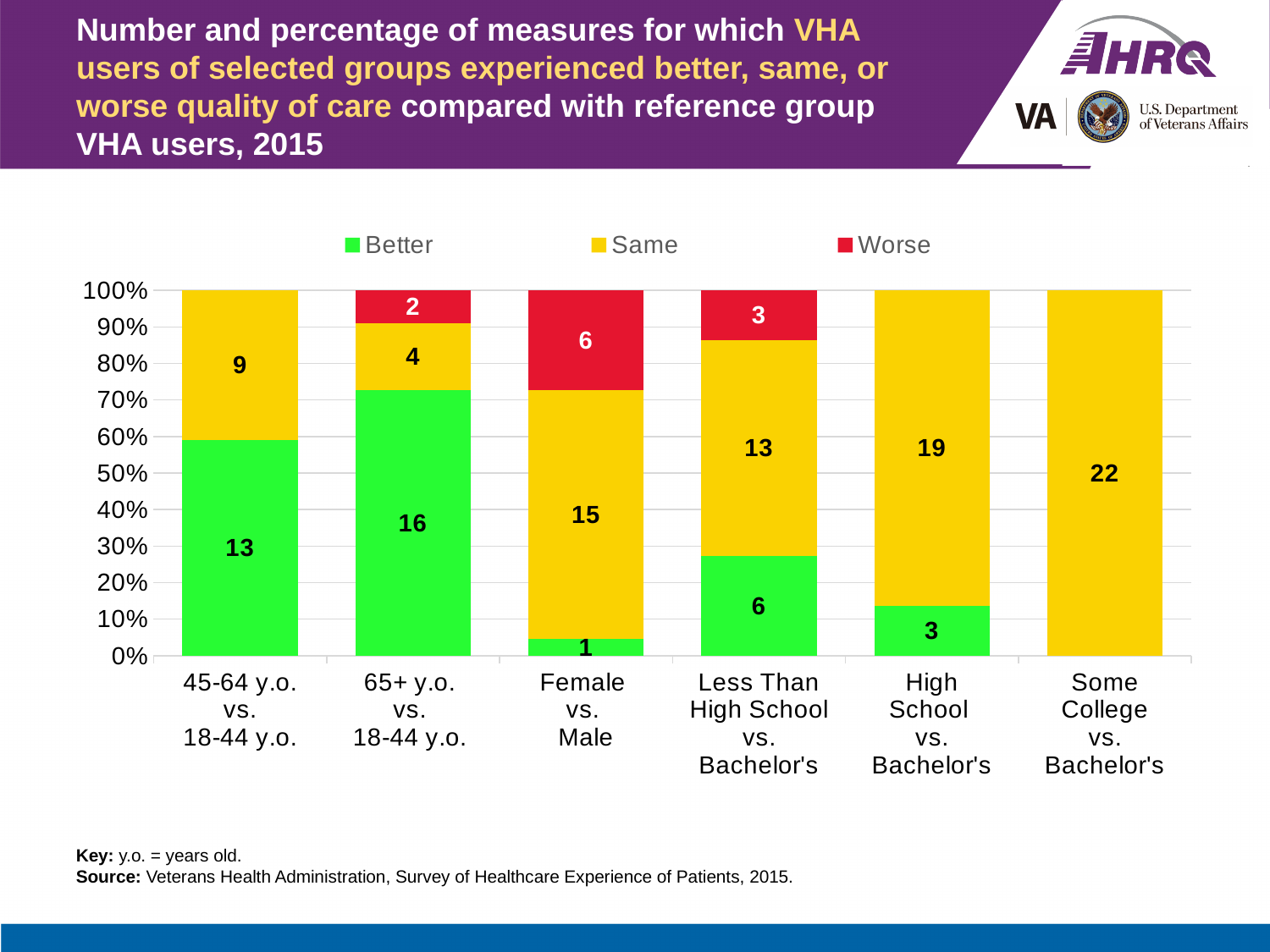
What is the total number of measures in the Female vs. Male bar? 22 What colour represents the 'Worse' series in the legend? Red What is the difference between the 'Same' count for High School vs. Bachelor's and the 'Same' count for Less Than High School vs. Bachelor's? 6 Which group has the highest number of 'Better' measures? 65+ y.o. vs. 18-44 y.o. How many measures were 'Better' for 65+ y.o. vs. 18-44 y.o.? 16 Which group has the lowest number of 'Better' measures among those with a 'Better' label? Female vs. Male Which is larger: the 'Better' count for 45-64 y.o. vs. 18-44 y.o. or the 'Better' count for Less Than High School vs. Bachelor's? 45-64 y.o. vs. 18-44 y.o. How many measures were 'Same' for Some College vs. Bachelor's? 22 How many comparison groups are shown along the x axis? 6 How many measures were 'Worse' for Female vs. Male? 6 What kind of chart is shown on the slide? Stacked bar chart How many series does the legend list? 3